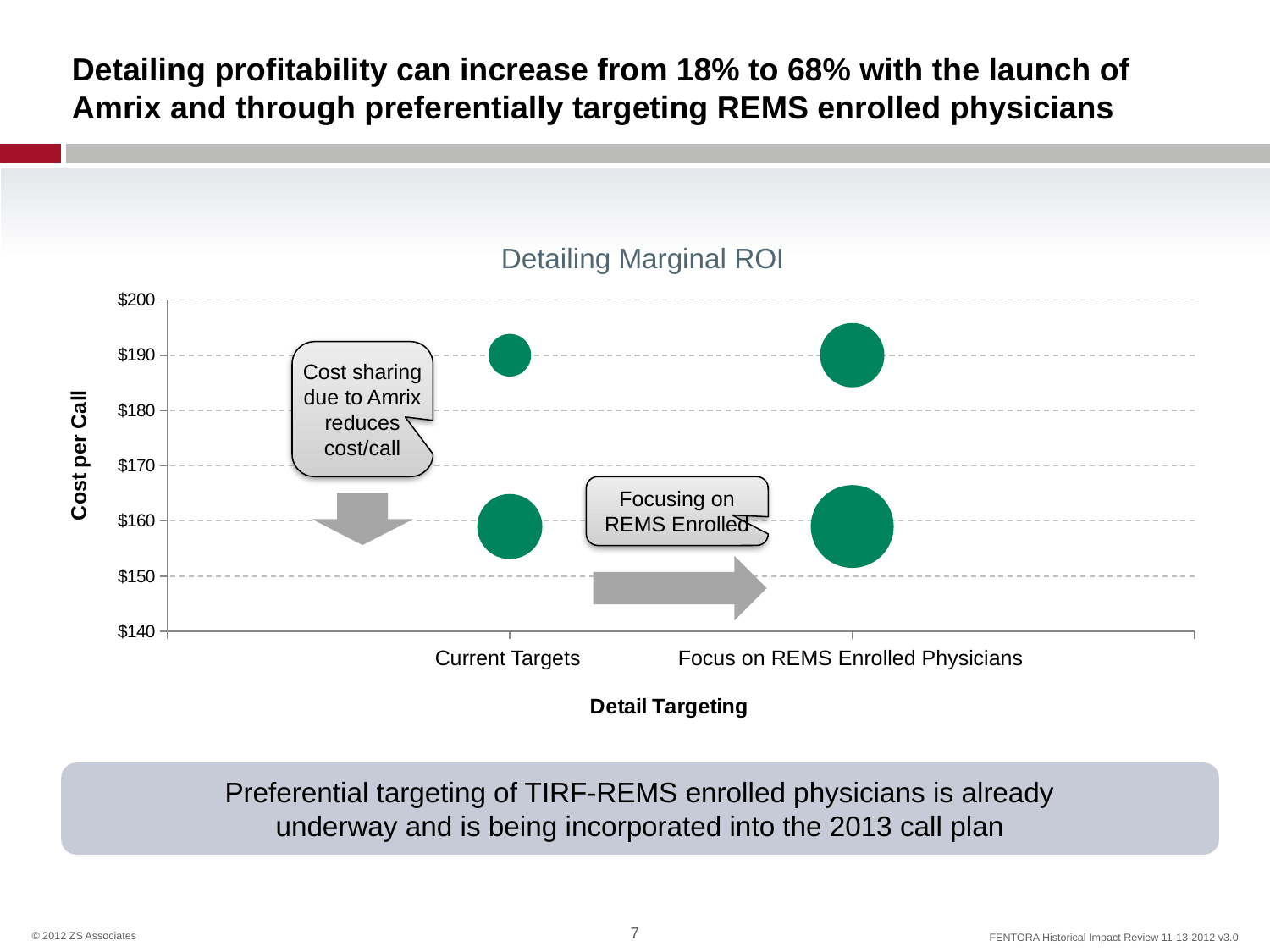
Is the value of the lower bubble for Current Targets greater or less than $170? less Is the value of the lower bubble for Focus on REMS Enrolled Physicians greater or less than $150? greater Which is higher on the Cost per Call axis for Current Targets: the upper bubble or the lower bubble? The upper bubble How many categories are shown on the x axis of the chart? 2 How many bubbles are plotted on the chart? 4 Is the value of the upper bubble for Current Targets greater or less than $180? greater What kind of chart is shown on the slide? Bubble chart What is the highest value shown on the Cost per Call axis? $200 What is the title of the chart? Detailing Marginal ROI